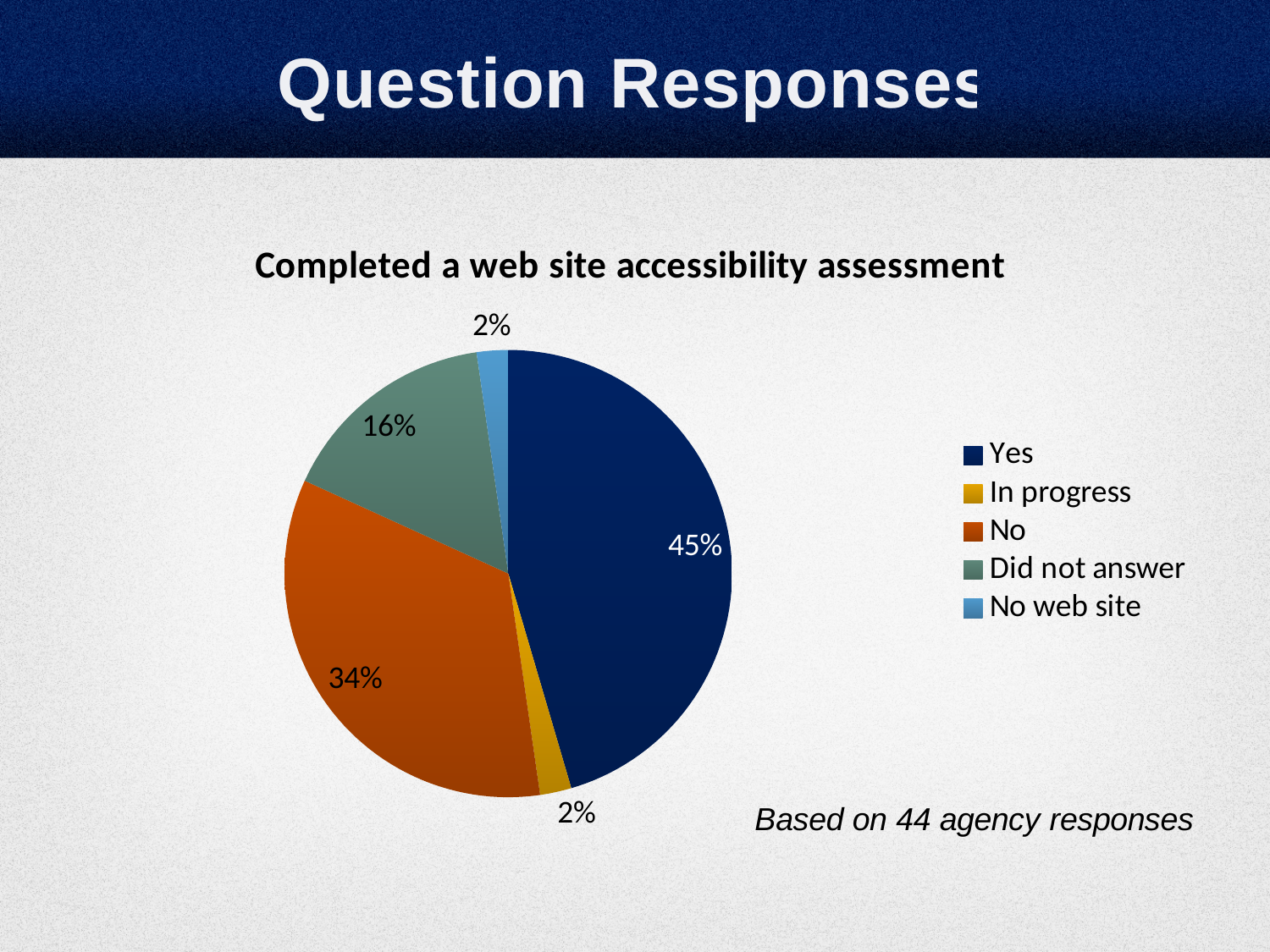
Which category has the largest share of the pie? Yes What is the title of the chart? Completed a web site accessibility assessment What type of chart is shown on the slide? Pie chart What percentage of responses were "Did not answer"? 16% What percentage of responses were "No"? 34% What percentage of responses were "In progress"? 2% How many agency responses is the chart based on? 44 What percentage of responses were "Yes"? 45% What is the combined share of "Yes" and "No"? 79% What is the difference in percentage points between "Yes" and "No"? 11 How many categories does the legend list? 5 Which is larger, the share for "No" or the share for "Did not answer"? No